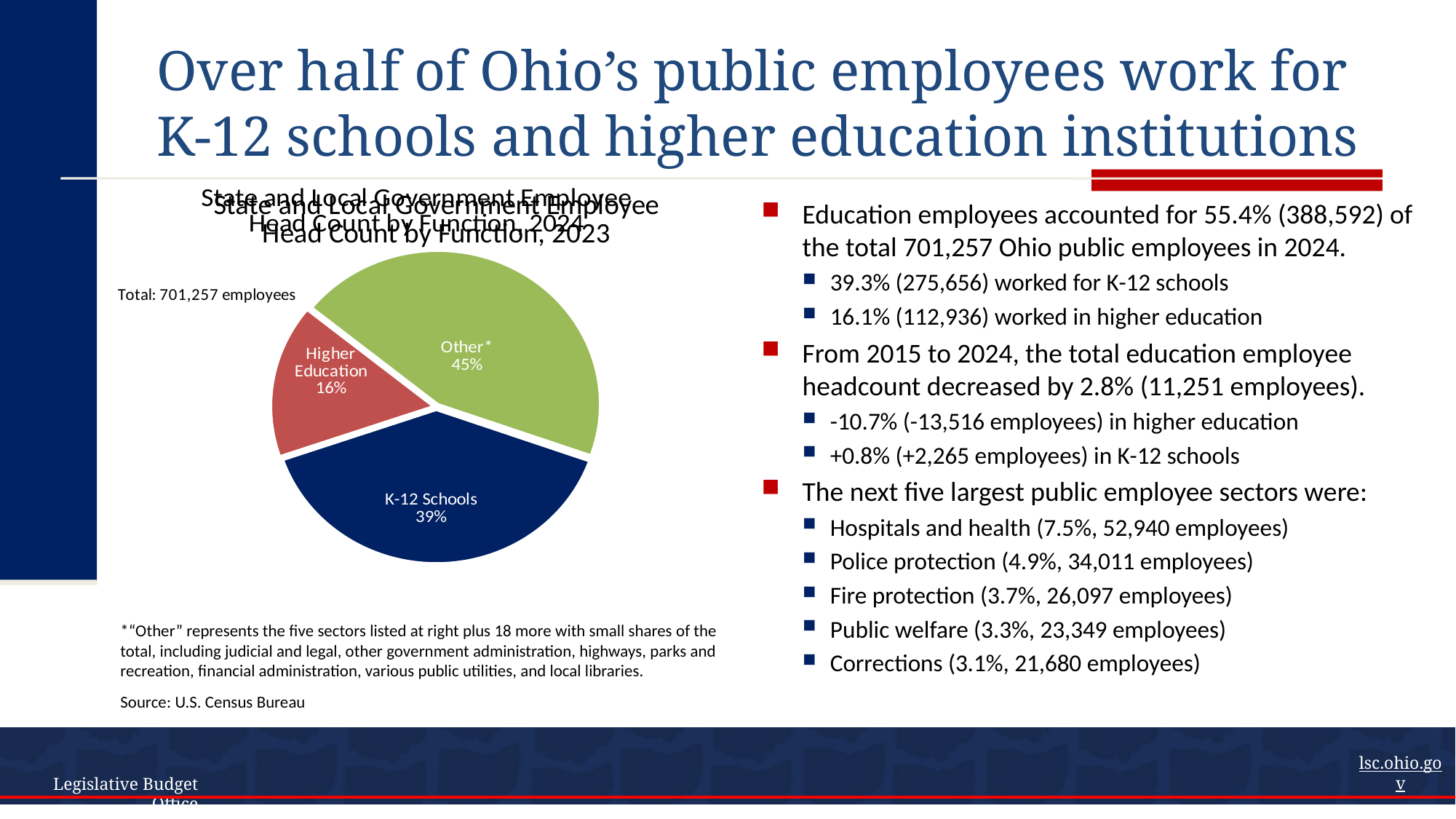
How many slices does the pie chart have? 3 What share of the pie does the Other* slice represent? 45% What kind of chart is shown on the slide? pie chart What share of the pie does Higher Education represent? 16% Which slice of the pie chart is the smallest? Higher Education What colour is the K-12 Schools slice in the pie chart? dark blue What is the combined share of the K-12 Schools and Higher Education slices? 55% Which is larger, the K-12 Schools slice or the Other* slice? Other* What share of the pie does K-12 Schools represent? 39% What total number of employees is stated next to the pie chart? 701,257 employees Which slice of the pie chart is the largest? Other* What is the difference in percentage points between the K-12 Schools slice and the Higher Education slice? 23 percentage points